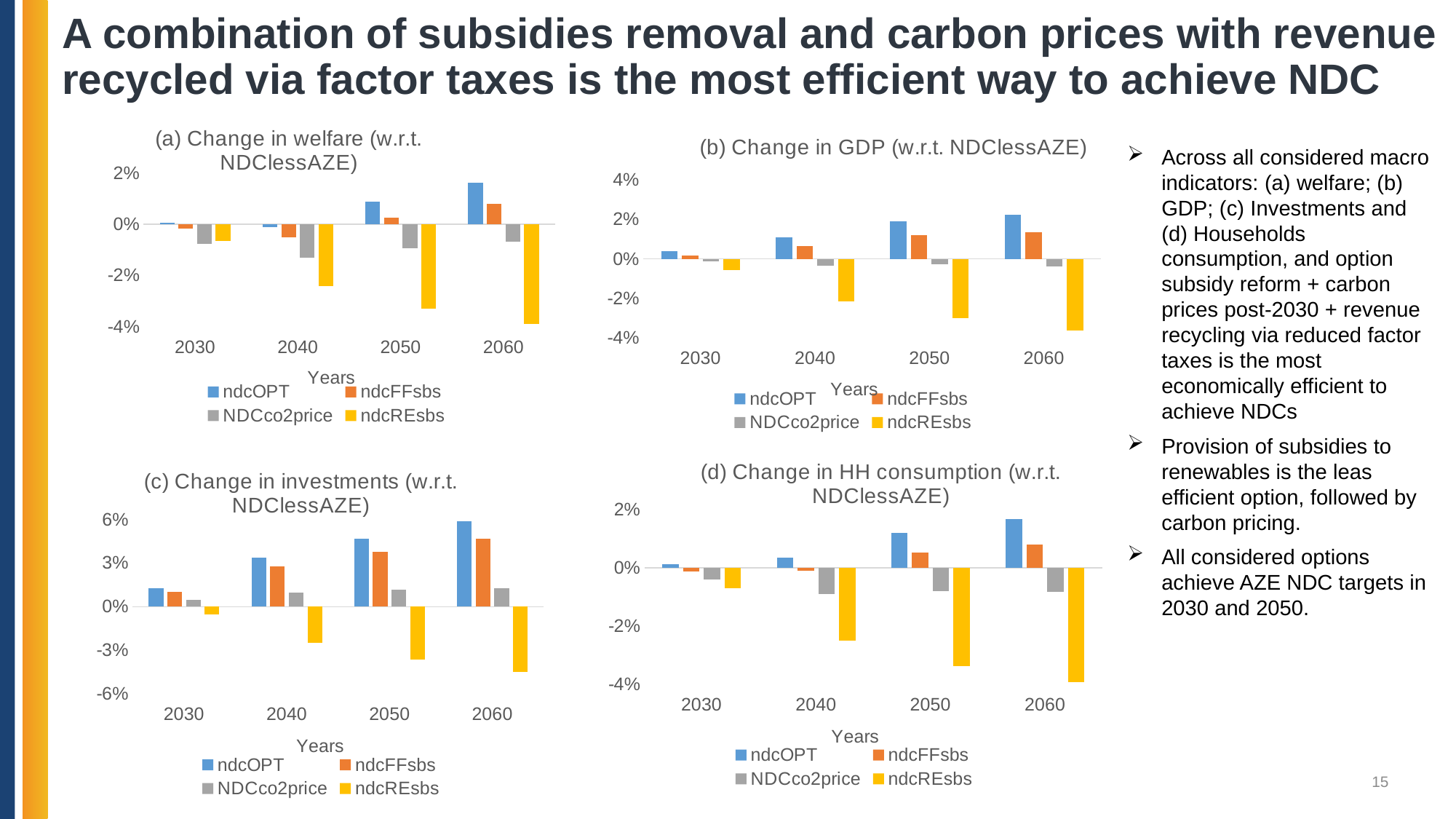
In "(b) Change in GDP (w.r.t. NDClessAZE)", which series has the lowest value in 2060? ndcREsbs In "(c) Change in investments (w.r.t. NDClessAZE)", which is larger in 2060: ndcOPT or ndcFFsbs? ndcOPT In "(b) Change in GDP (w.r.t. NDClessAZE)", is the value for ndcREsbs in 2060 greater or less than -2%? less In "(d) Change in HH consumption (w.r.t. NDClessAZE)", is the value for ndcREsbs in 2060 greater or less than -2%? less In "(c) Change in investments (w.r.t. NDClessAZE)", which series has the highest value in 2060? ndcOPT How many years are shown on the x axis of "(c) Change in investments (w.r.t. NDClessAZE)"? 4 How many series does the legend of "(b) Change in GDP (w.r.t. NDClessAZE)" list? 4 In "(a) Change in welfare (w.r.t. NDClessAZE)", is the value for ndcREsbs in 2060 greater or less than -2%? less What is the x-axis title of "(d) Change in HH consumption (w.r.t. NDClessAZE)"? Years What kind of chart is "(a) Change in welfare (w.r.t. NDClessAZE)"? bar chart In "(b) Change in GDP (w.r.t. NDClessAZE)", do the ndcOPT values rise or fall from 2030 to 2060? rise